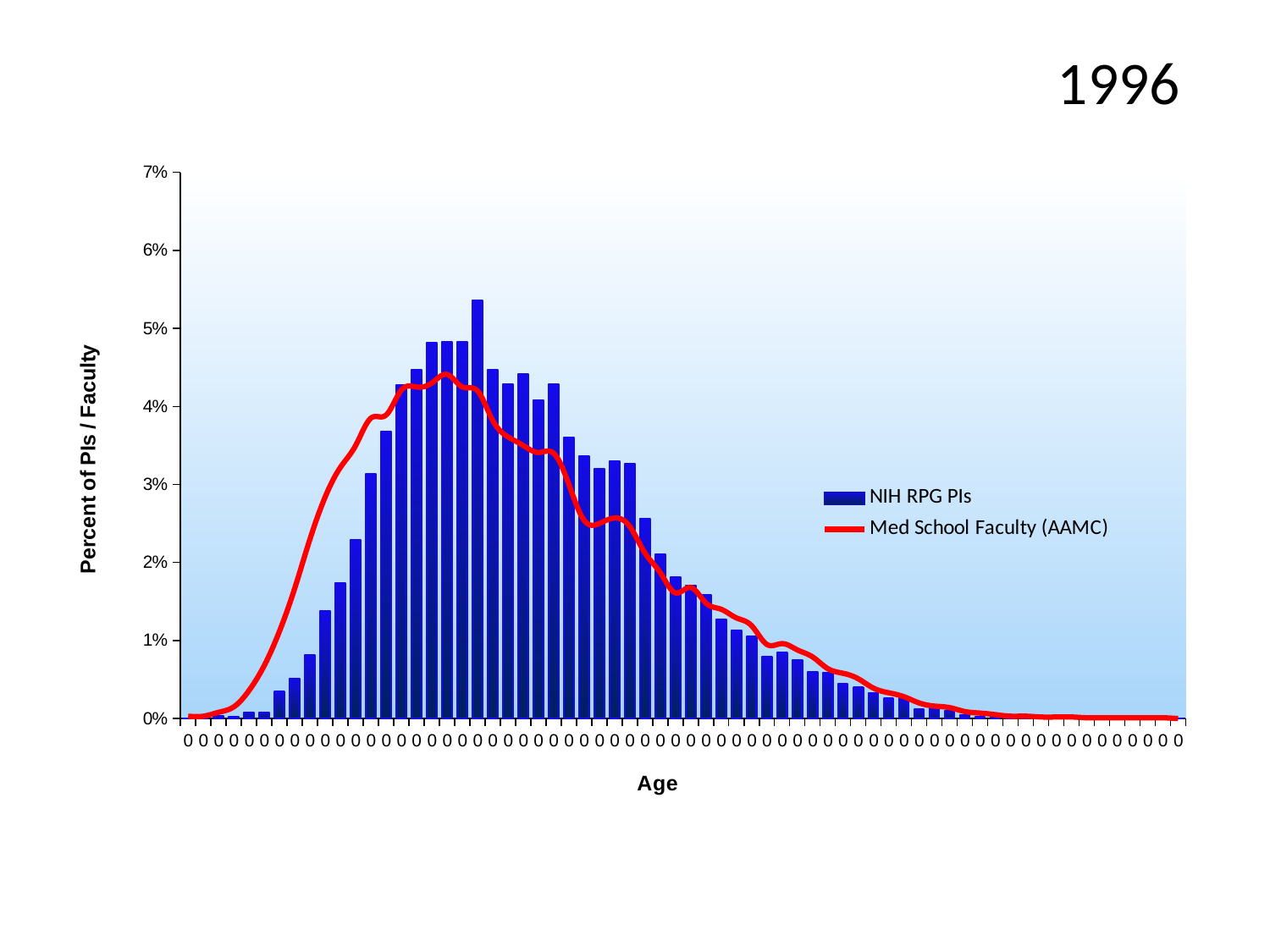
Is the value of the tallest NIH RPG PIs bar greater or less than 6%? less What is the title of the vertical axis? Percent of PIs / Faculty Is the peak value of the Med School Faculty (AAMC) line greater or less than 4%? greater Which series reaches a higher peak value, NIH RPG PIs or Med School Faculty (AAMC)? NIH RPG PIs After the tallest bar, do the NIH RPG PIs values generally rise or fall as age increases along the x axis? fall Do the Med School Faculty (AAMC) values rise or fall over the right half of the x axis? fall How many series does the legend list? 2 Is the peak value of the Med School Faculty (AAMC) line greater or less than 5%? less What year is shown as the title of the chart? 1996 What kind of chart is used to plot the NIH RPG PIs series? bar chart